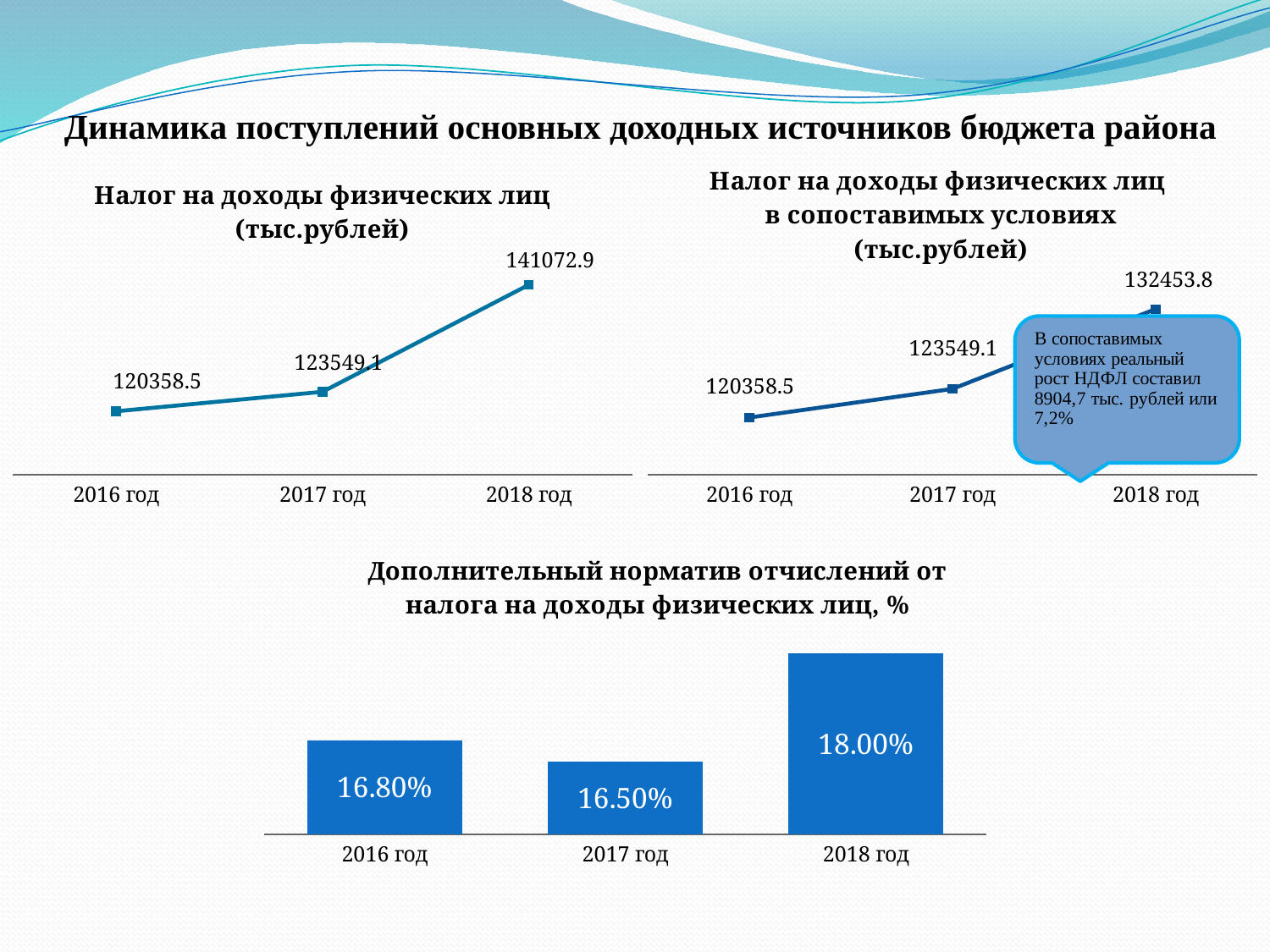
In the top-left chart 'Налог на доходы физических лиц (тыс.рублей)', what is the difference between the 2018 год and 2016 год values? 20714.4 In the top-left chart 'Налог на доходы физических лиц (тыс.рублей)', what is the value for 2018 год? 141072.9 In the top-right chart 'Налог на доходы физических лиц в сопоставимых условиях (тыс.рублей)', do the values rise or fall from 2016 год to 2018 год? rise What kind of chart is the bottom chart 'Дополнительный норматив отчислений от налога на доходы физических лиц, %'? bar chart In the top-right chart 'Налог на доходы физических лиц в сопоставимых условиях (тыс.рублей)', what is the value for 2018 год? 132453.8 In the top-left chart 'Налог на доходы физических лиц (тыс.рублей)', what is the value for 2016 год? 120358.5 How many years are shown on the x axis of the bottom chart 'Дополнительный норматив отчислений от налога на доходы физических лиц, %'? 3 In the bottom chart 'Дополнительный норматив отчислений от налога на доходы физических лиц, %', which year has the lowest value? 2017 год In the top-right chart 'Налог на доходы физических лиц в сопоставимых условиях (тыс.рублей)', what is the difference between the 2018 год and 2017 год values? 8904.7 In the bottom chart 'Дополнительный норматив отчислений от налога на доходы физических лиц, %', which year has the highest value? 2018 год What kind of chart is the top-left chart 'Налог на доходы физических лиц (тыс.рублей)'? line chart In the bottom chart 'Дополнительный норматив отчислений от налога на доходы физических лиц, %', what is the value for 2017 год? 16.50%